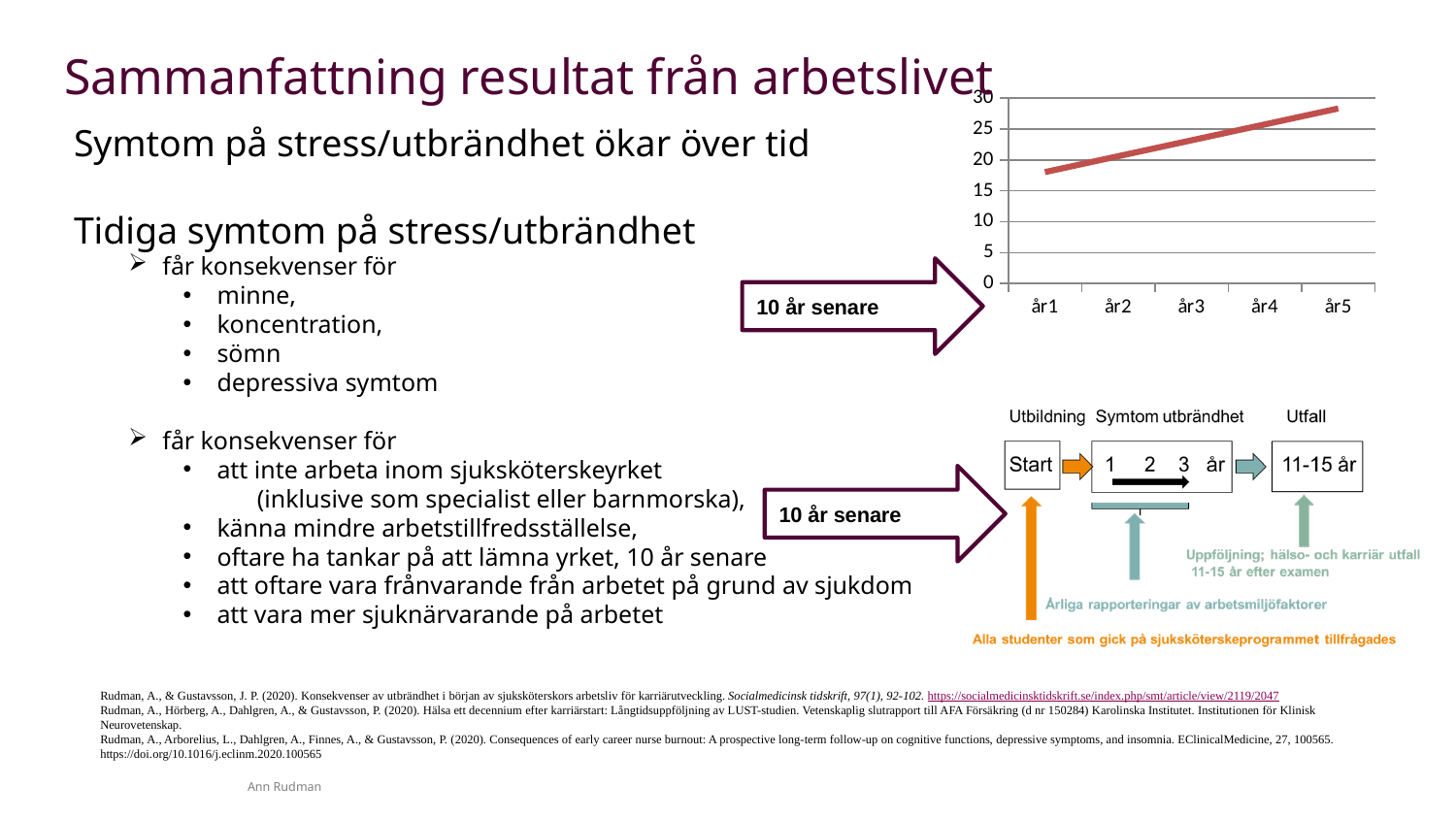
What kind of chart is shown on the slide? line chart What is the highest tick value shown on the y axis of the line chart? 30 What is the label of the first category on the x axis of the line chart? år1 Which x-axis category has the lowest value in the line chart? år1 Is the value for år5 greater or less than 30? less How many points along the x axis does the line chart have? 5 Is the value for år1 greater or less than 15? greater Is the value for år5 greater or less than 25? greater Which is larger in the line chart, the value for år5 or the value for år1? år5 Do the values in the line chart rise or fall from år1 to år5? rise Which x-axis category has the highest value in the line chart? år5